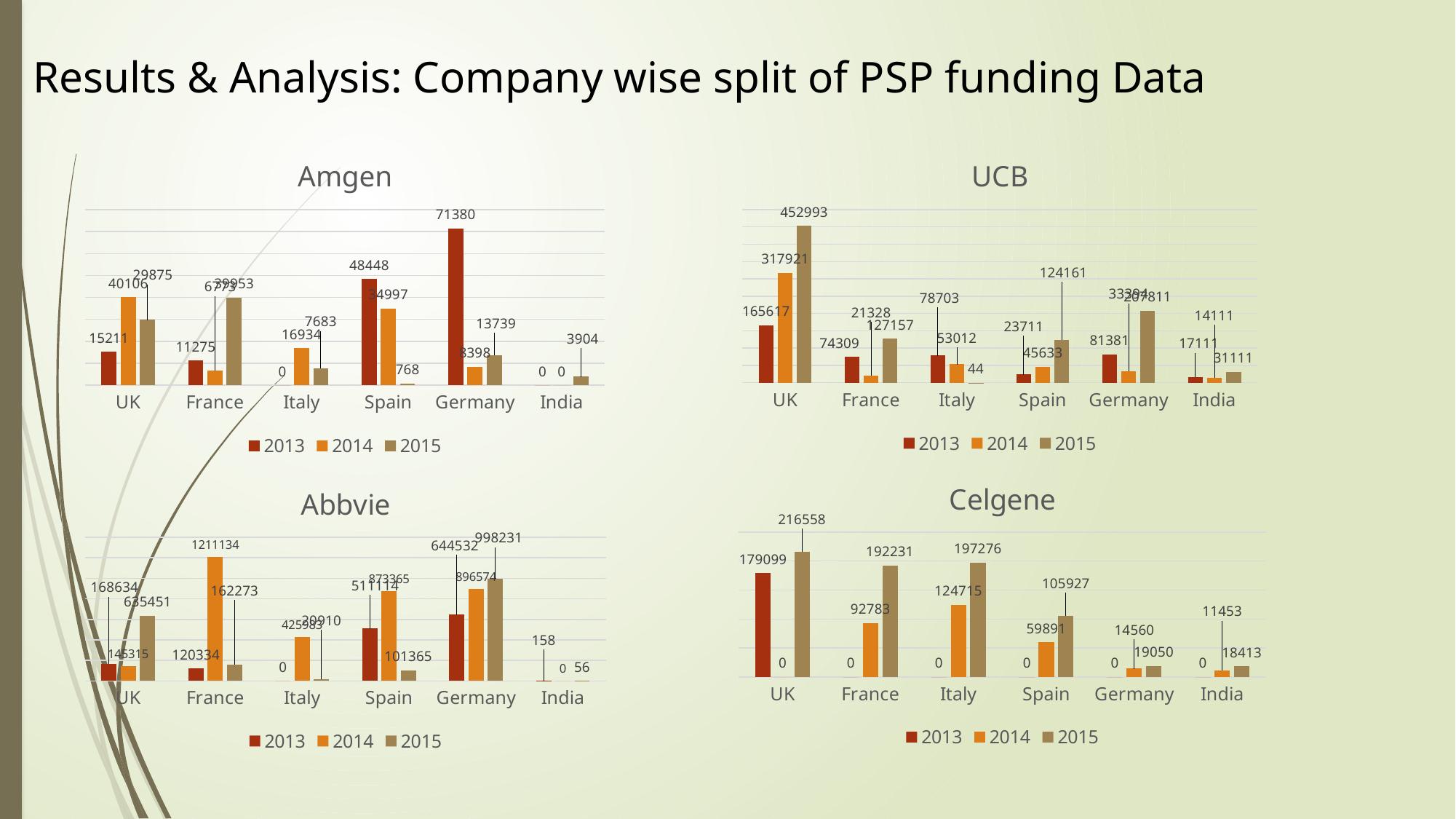
How many series does the legend of the Celgene chart list? 3 In the UCB chart, what is the value for Italy in 2015? 44 In the Celgene chart, what is the value for Italy in 2015? 197276 In the Amgen chart, which country has the highest 2014 value? UK In the UCB chart, what is the value for the UK in 2015? 452993 In the Amgen chart, what is the value for Germany in 2013? 71380 What type of chart is the UCB chart? Bar chart In the Abbvie chart, which country has the highest 2015 value? Germany In the Abbvie chart, what is the value for France in 2014? 1211134 In the Amgen chart, what is the difference between the 2013 and 2014 values for Spain? 13451 In the UCB chart, which is larger for Spain: the 2013 value or the 2014 value? 2014 In the Celgene chart, what is the difference between the 2015 and 2014 values for France? 99448